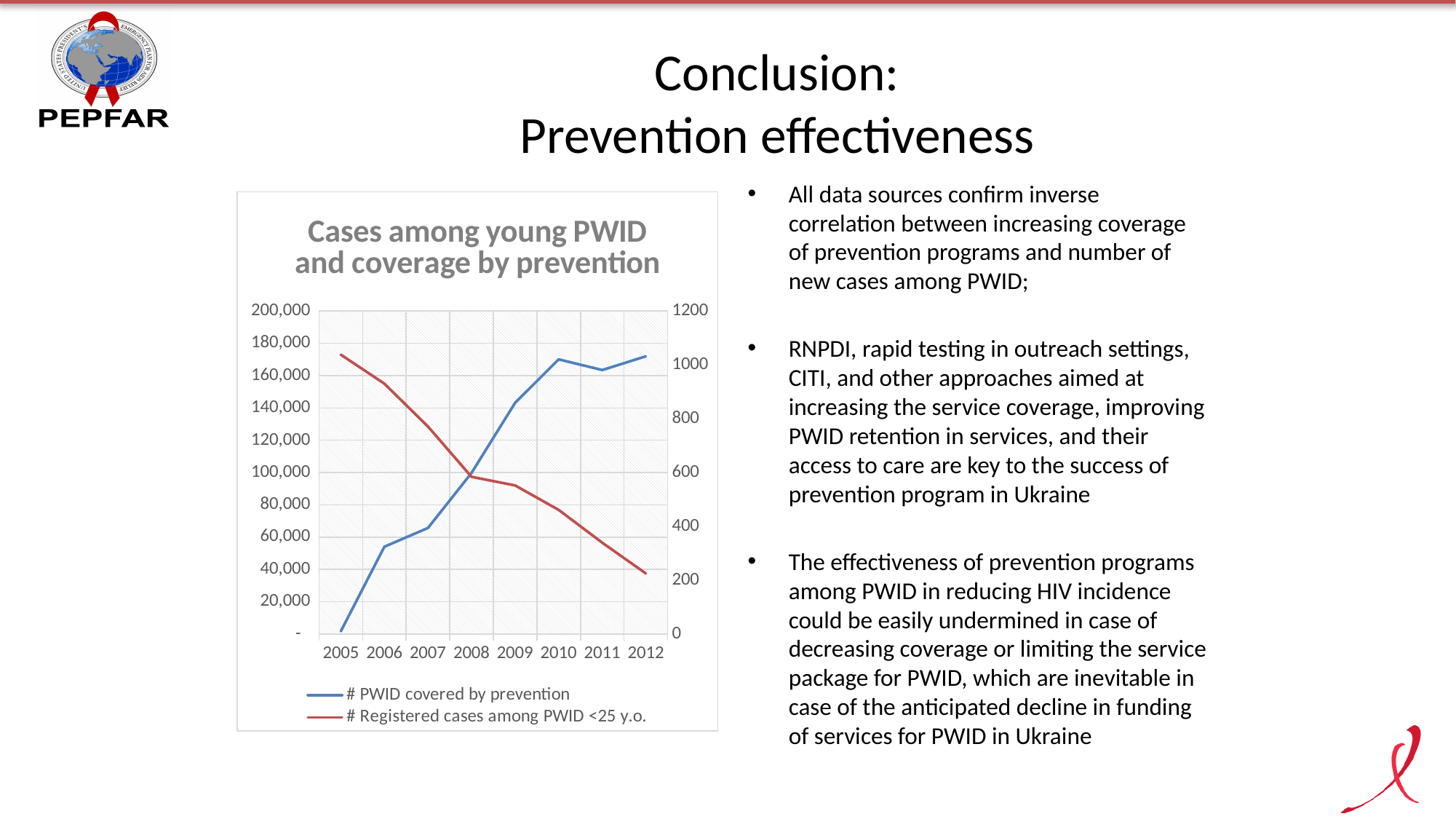
Does the number of PWID covered by prevention generally rise or fall from 2005 to 2012? rise In which year is the number of registered cases among PWID <25 y.o. lowest? 2012 In which year is the number of registered cases among PWID <25 y.o. highest? 2005 In which year is the number of PWID covered by prevention lowest? 2005 Is the number of PWID covered by prevention in 2012 greater or less than 160,000? greater How many years are plotted along the x axis of the chart? 8 What kind of chart is shown on the slide? line chart What is the title of the chart? Cases among young PWID and coverage by prevention Which series is drawn in red on the chart? # Registered cases among PWID <25 y.o. Is the number of registered cases among PWID <25 y.o. in 2011 greater or less than 400? less Does the number of registered cases among PWID <25 y.o. rise or fall from 2005 to 2012? fall How many series does the chart legend list? 2